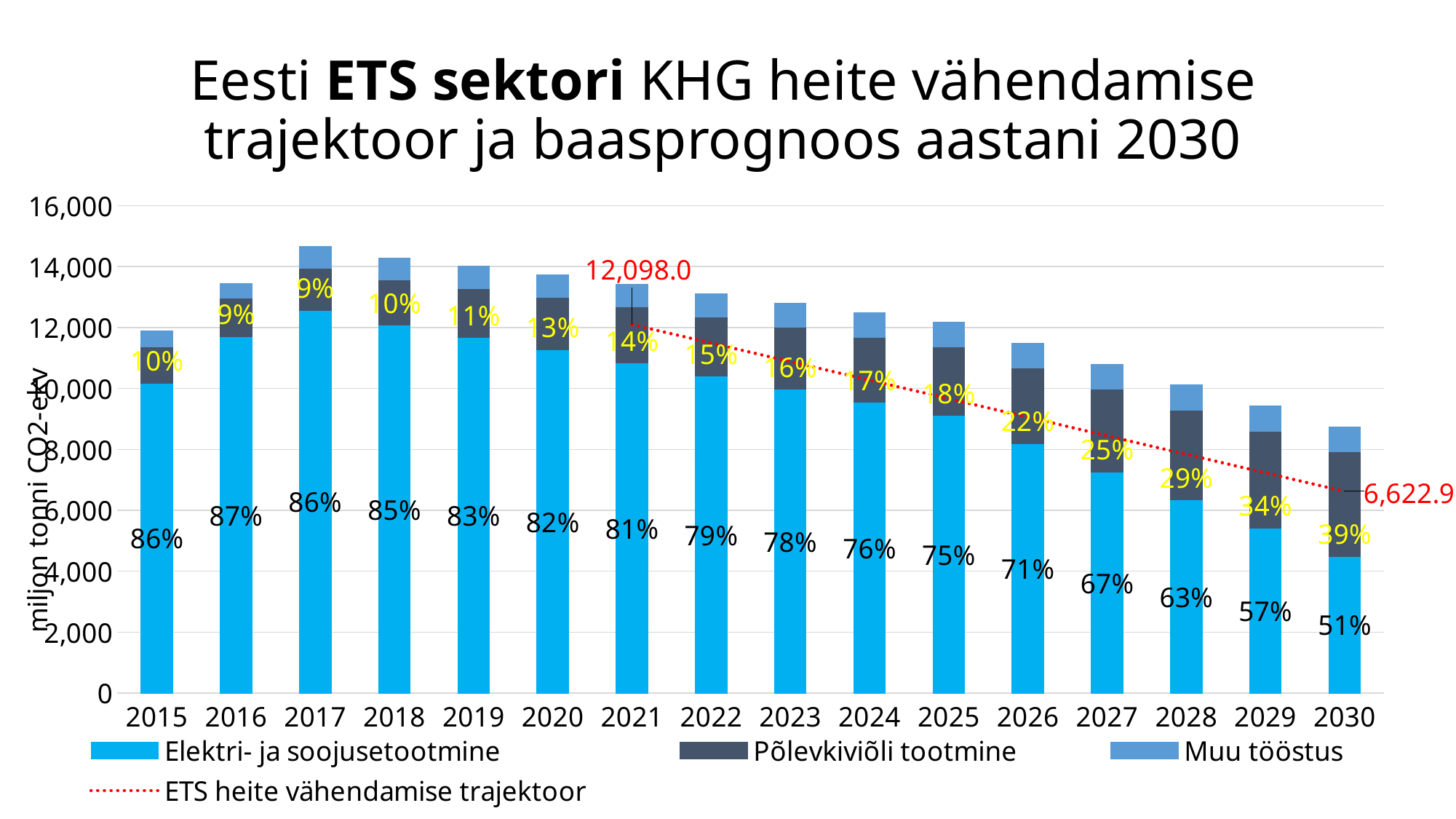
Which year has the tallest stacked bar? 2017 What value is labelled on the ETS heite vähendamise trajektoor line for 2030? 6,622.9 What percentage label is shown for Elektri- ja soojusetootmine in 2015? 86% Do the percentage labels for Elektri- ja soojusetootmine rise or fall from 2017 to 2030? fall What kind of chart is this? Stacked bar chart with a dotted line What value is labelled on the ETS heite vähendamise trajektoor line for 2021? 12,098.0 How many years are shown on the x axis? 16 Is the total stacked bar for 2030 greater or less than 10,000? less What is the difference between the trajectory line values labelled for 2021 and 2030? 5,475.1 How many entries does the legend list? 4 What percentage label is shown for Elektri- ja soojusetootmine in 2030? 51% What percentage label is shown for Põlevkiviõli tootmine in 2030? 39%